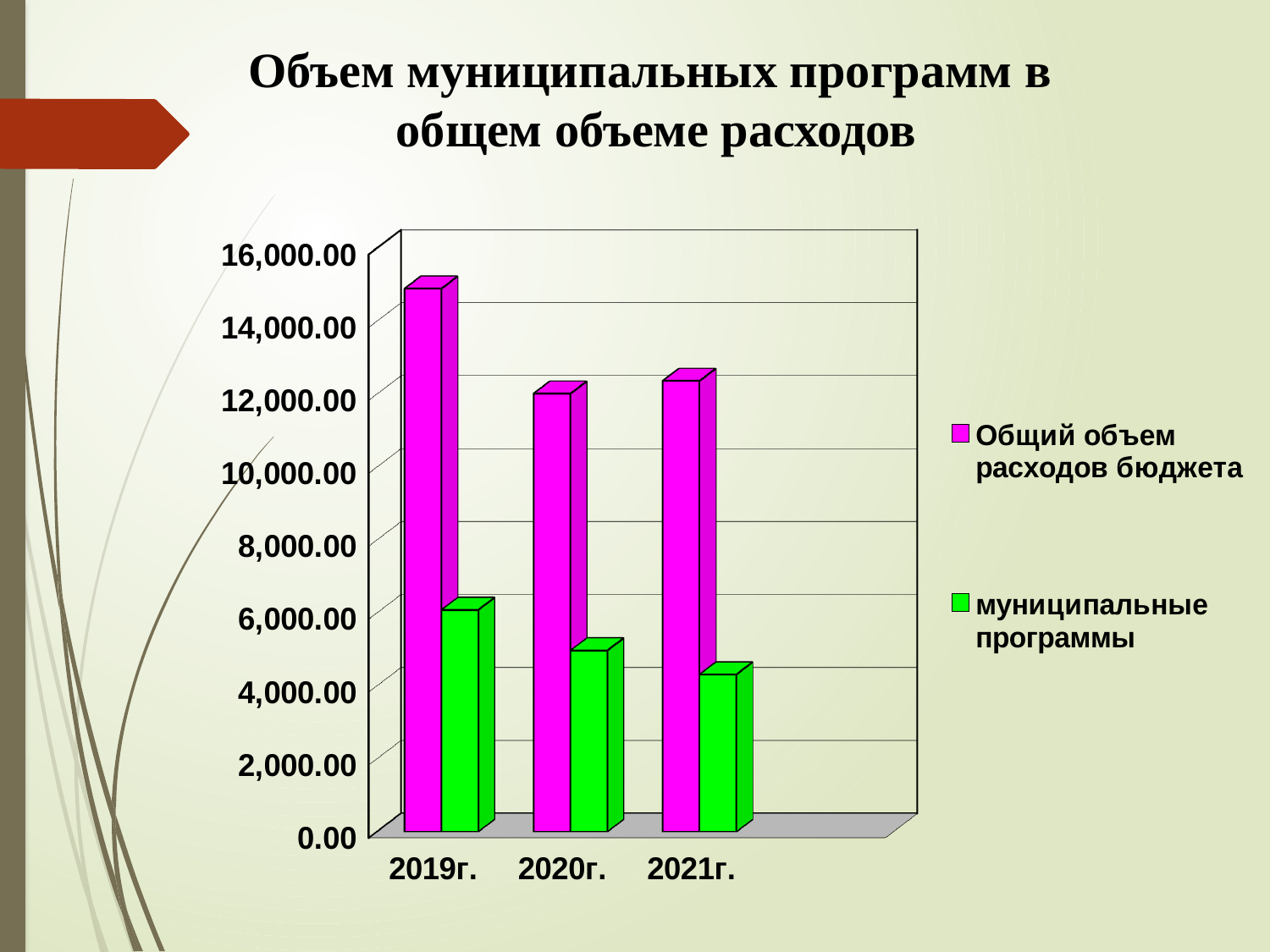
How many series does the legend list? 2 Is the value for 'муниципальные программы' in 2020г. greater or less than 6,000.00? less Is the value for 'Общий объем расходов бюджета' in 2019г. greater or less than 14,000.00? greater Do the values for 'муниципальные программы' rise or fall from 2019г. to 2021г.? fall Which is larger: 'Общий объем расходов бюджета' in 2019г. or in 2021г.? 2019г. Is the value for 'муниципальные программы' in 2020г. greater or less than 4,000.00? greater How many years are shown on the x axis? 3 In which year is 'Общий объем расходов бюджета' highest? 2019г. Which colour represents the series 'муниципальные программы'? green What is the title of the chart? Объем муниципальных программ в общем объеме расходов In which year is 'муниципальные программы' lowest? 2021г. What kind of chart is shown on the slide? bar chart